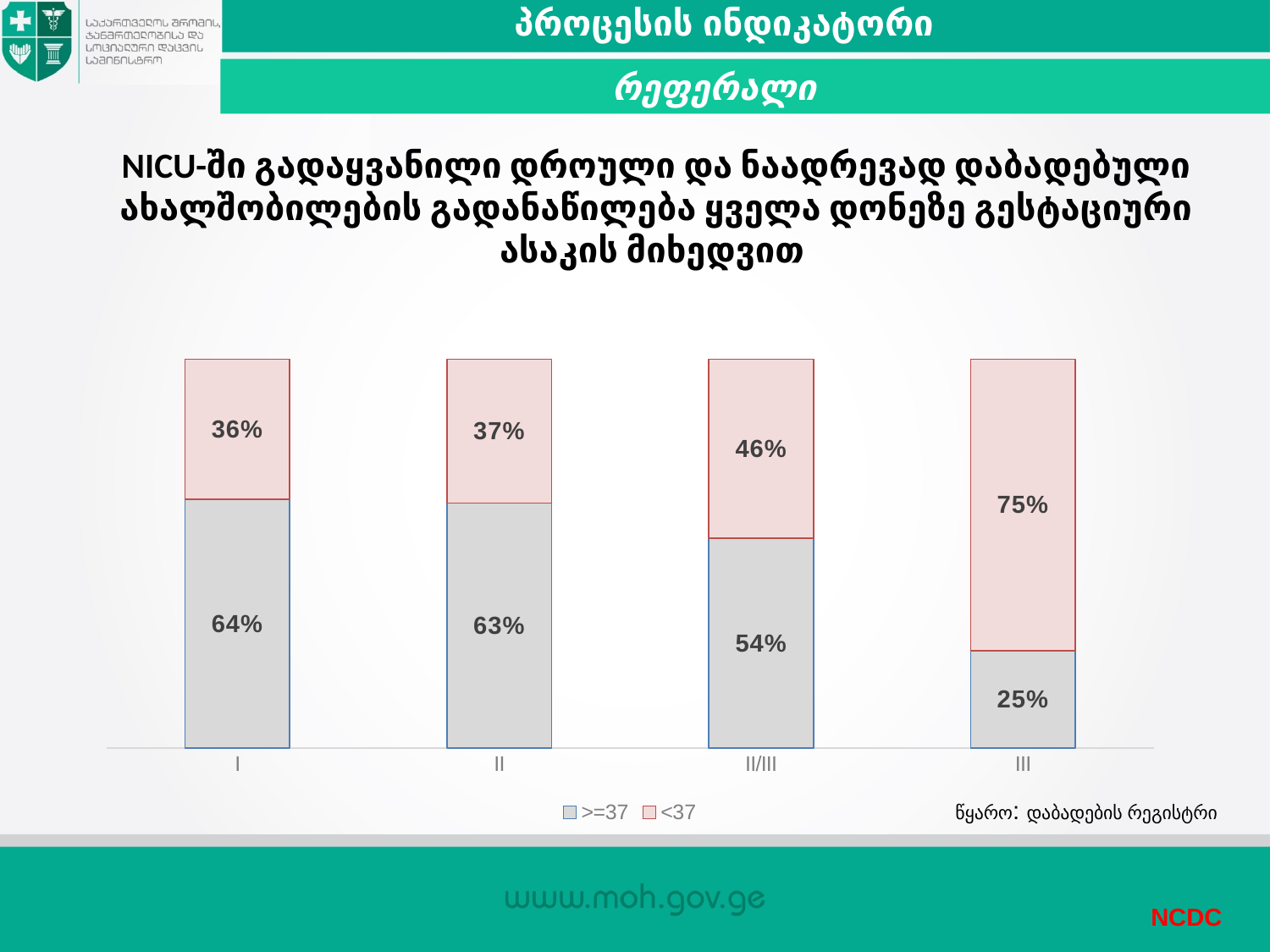
What is the value for ">=37" in category II? 63% What is the value for "<37" in category II/III? 46% Which category has the lowest value for ">=37"? III What is the value for ">=37" in category I? 64% Does the "<37" value rise or fall from category I to category III? Rise What kind of chart is shown on the slide? Stacked bar chart How many categories are shown on the x axis? 4 What is the difference between the ">=37" value in category I and the ">=37" value in category III? 39% How many series does the legend list? 2 What is the value for "<37" in category III? 75% Which category has the highest value for "<37"? III Which is larger: the "<37" value in category II or the "<37" value in category II/III? II/III